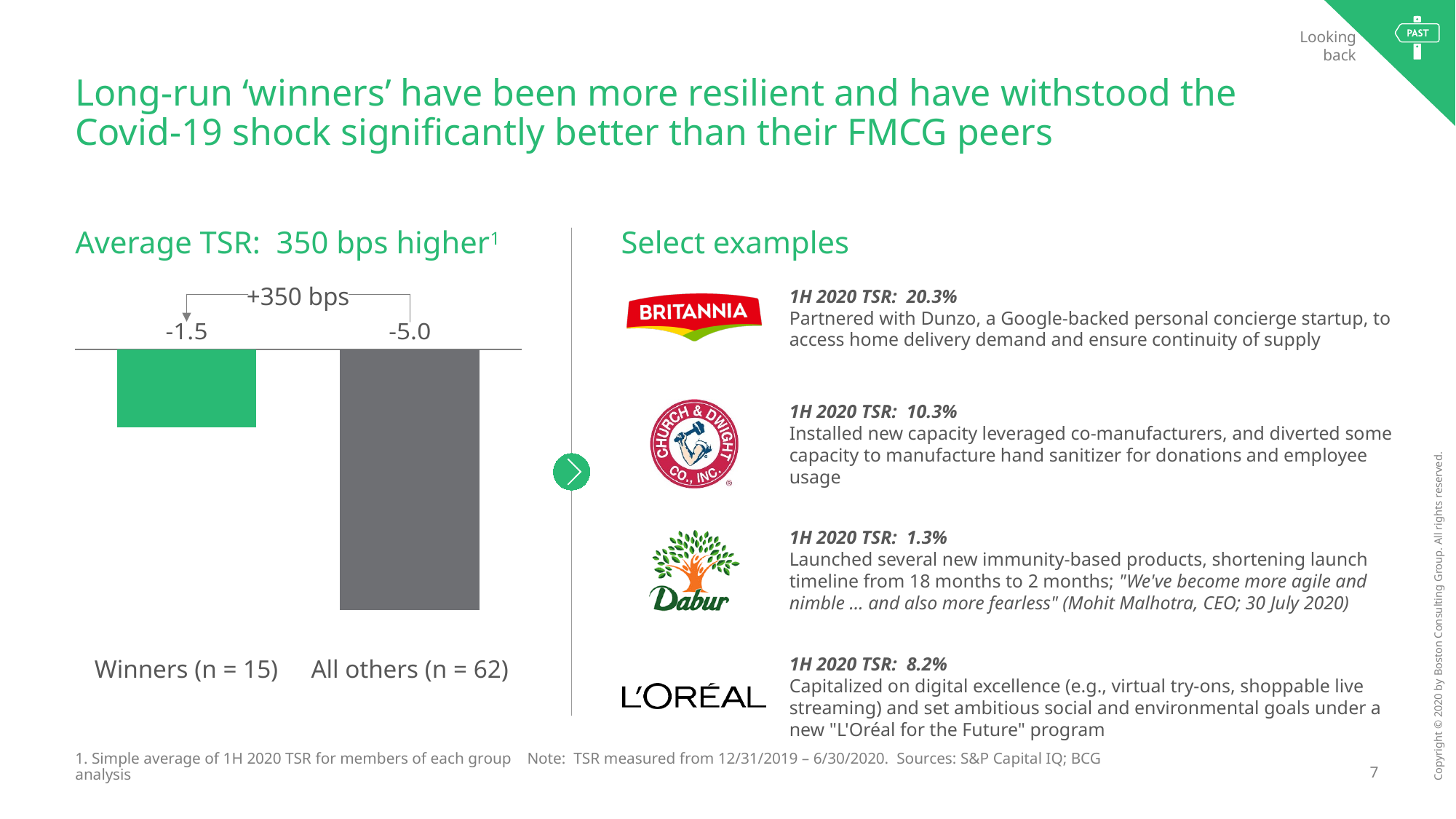
Which category has the higher average TSR, Winners or All others? Winners (n = 15) Which category has the highest value in the chart? Winners (n = 15) How many companies are in the Winners group according to the category label? 15 How many categories are plotted in the bar chart? 2 How many companies are in the All others group according to the category label? 62 What type of chart is used to show average TSR? Bar chart What is the difference between the Winners value and the All others value? 3.5 What is the average TSR value shown for Winners (n = 15)? -1.5 What is the heading above the chart? Average TSR: 350 bps higher What is the average TSR value shown for All others (n = 62)? -5.0 Which category has the lowest value in the chart? All others (n = 62) What gap in basis points is annotated between the two bars? +350 bps